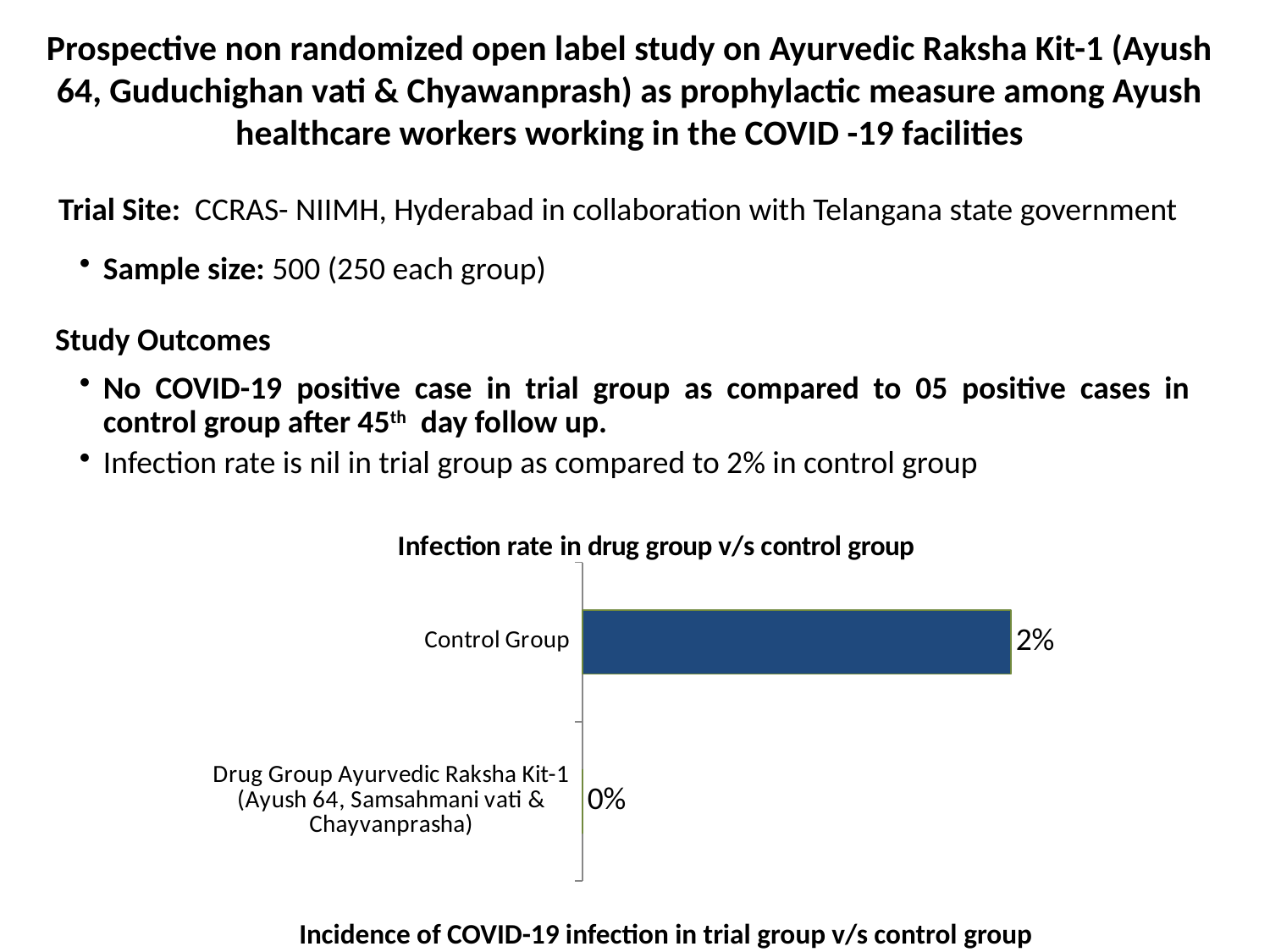
Which group has the higher infection rate? Control Group Is the infection rate larger for the Control Group or the Drug Group? Control Group What is the infection rate for the Control Group? 2% Which group has the lower infection rate? Drug Group Ayurvedic Raksha Kit-1 (Ayush 64, Samsahmani vati & Chayvanprasha) What is the caption printed below the chart? Incidence of COVID-19 infection in trial group v/s control group What is the difference in infection rate between the Control Group and the Drug Group? 2% What is the infection rate for the Drug Group Ayurvedic Raksha Kit-1? 0% What type of chart is shown on the slide? Bar chart What is the title of the chart? Infection rate in drug group v/s control group How many groups are shown in the chart? 2